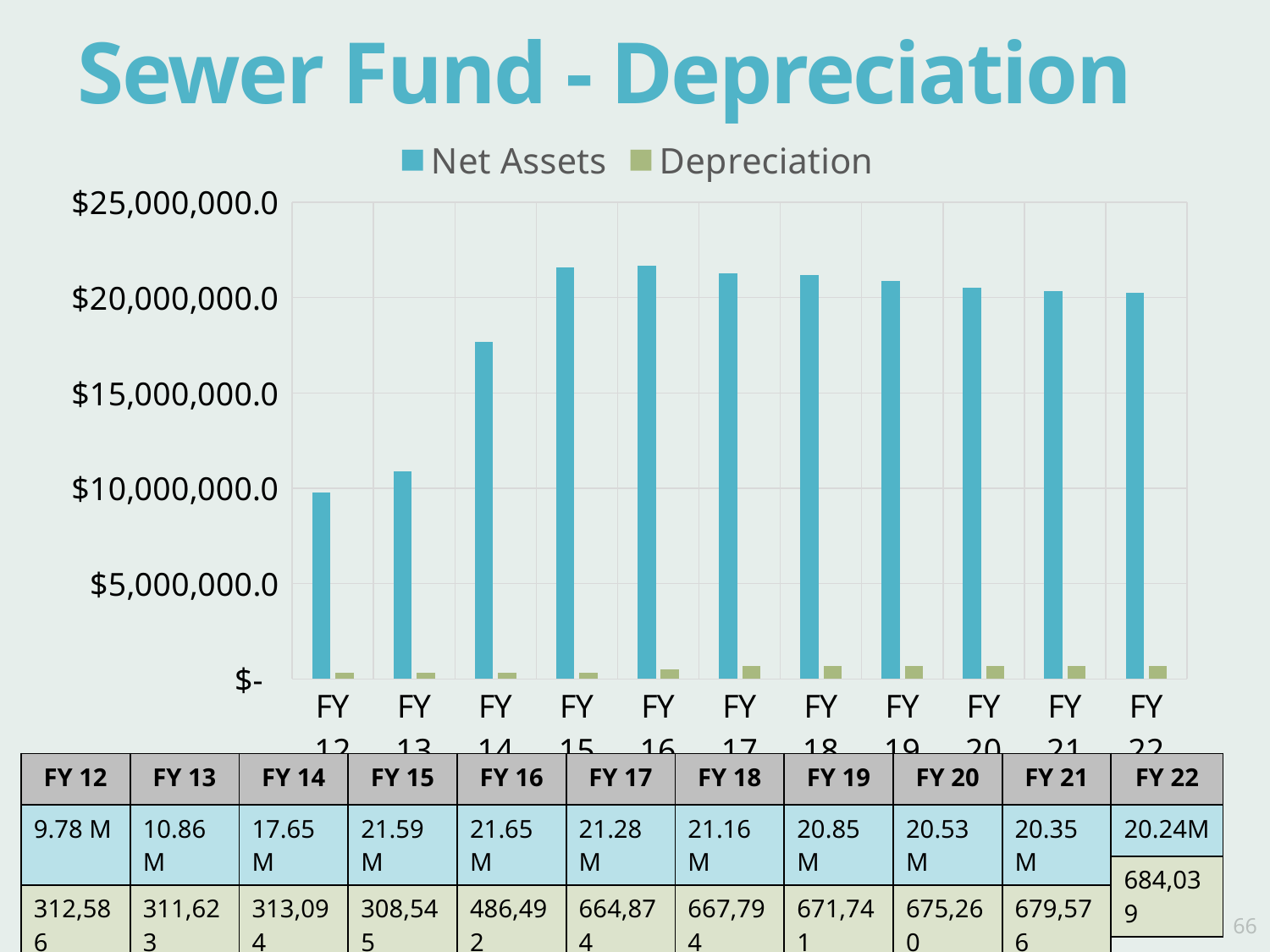
Which fiscal year has the lowest Depreciation? FY 15 What is the Depreciation value for FY 17? 664,874 How many series does the legend list? 2 What is the Net Assets value for FY 15? 21.59 M Which is larger, the Net Assets for FY 14 or for FY 13? FY 14 Is the Net Assets value for FY 12 greater or less than $10,000,000? less Which fiscal year has the highest Depreciation? FY 22 What is the Net Assets value for FY 22? 20.24M Do the Net Assets values rise or fall from FY 16 to FY 22? fall Which fiscal year has the lowest Net Assets? FY 12 How many fiscal years are shown on the x axis? 11 What is the difference between the Depreciation values for FY 22 and FY 21? 4,463